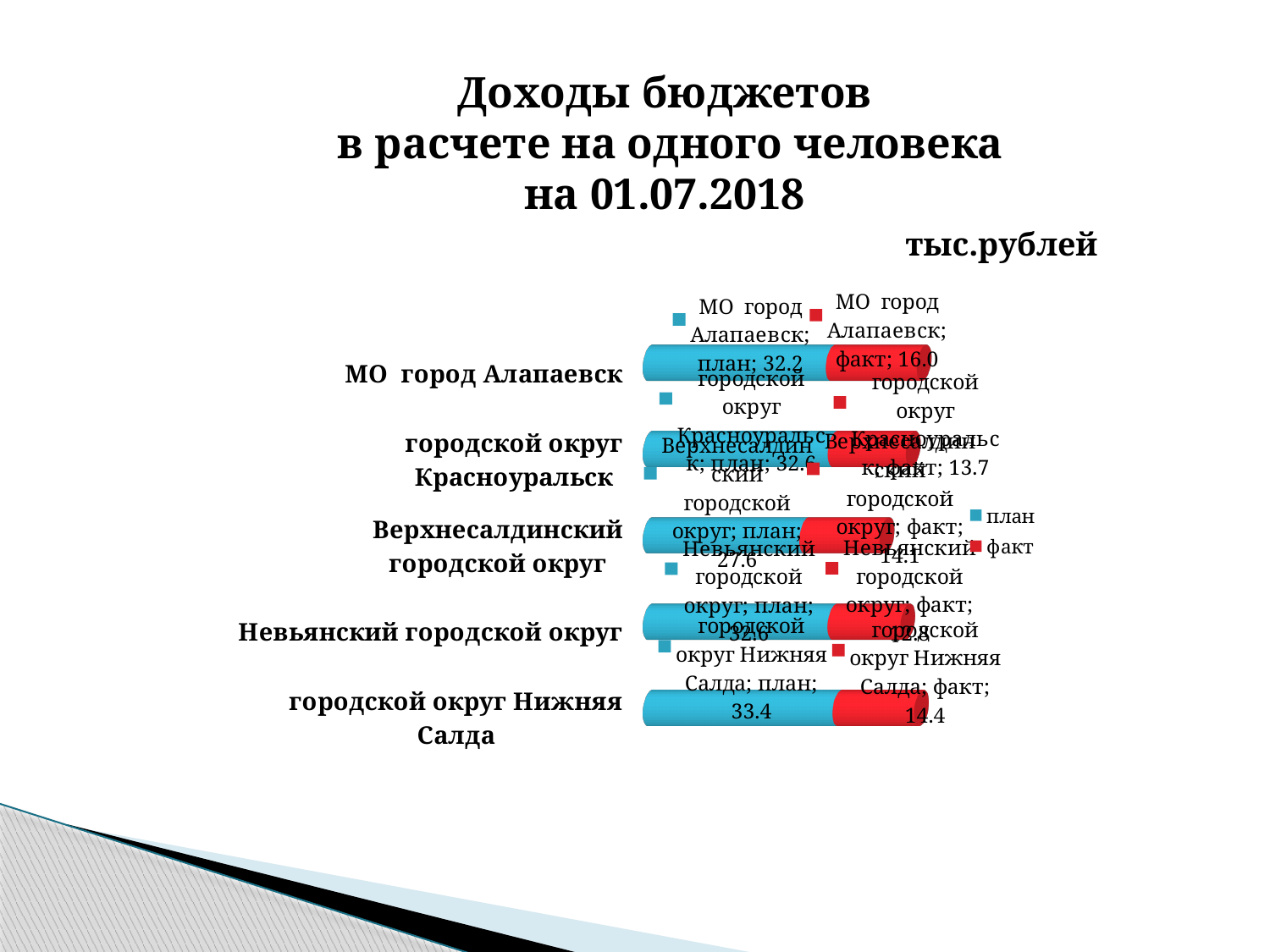
What is the план value for МО город Алапаевск? 32.2 What is the факт value for городской округ Красноуральск? 13.7 What is the факт value for МО город Алапаевск? 16.0 How many series does the legend list? 2 Which category has the highest факт value? МО город Алапаевск What is the план value for Верхнесалдинский городской округ? 27.6 How many categories (municipalities) are shown in the chart? 5 Which category has the lowest план value? Верхнесалдинский городской округ What is the total of the stacked bar for городской округ Нижняя Салда? 47.8 What is the difference between the план and факт values for МО город Алапаевск? 16.2 What is the план value for городской округ Нижняя Салда? 33.4 What kind of chart is shown on the slide? bar chart